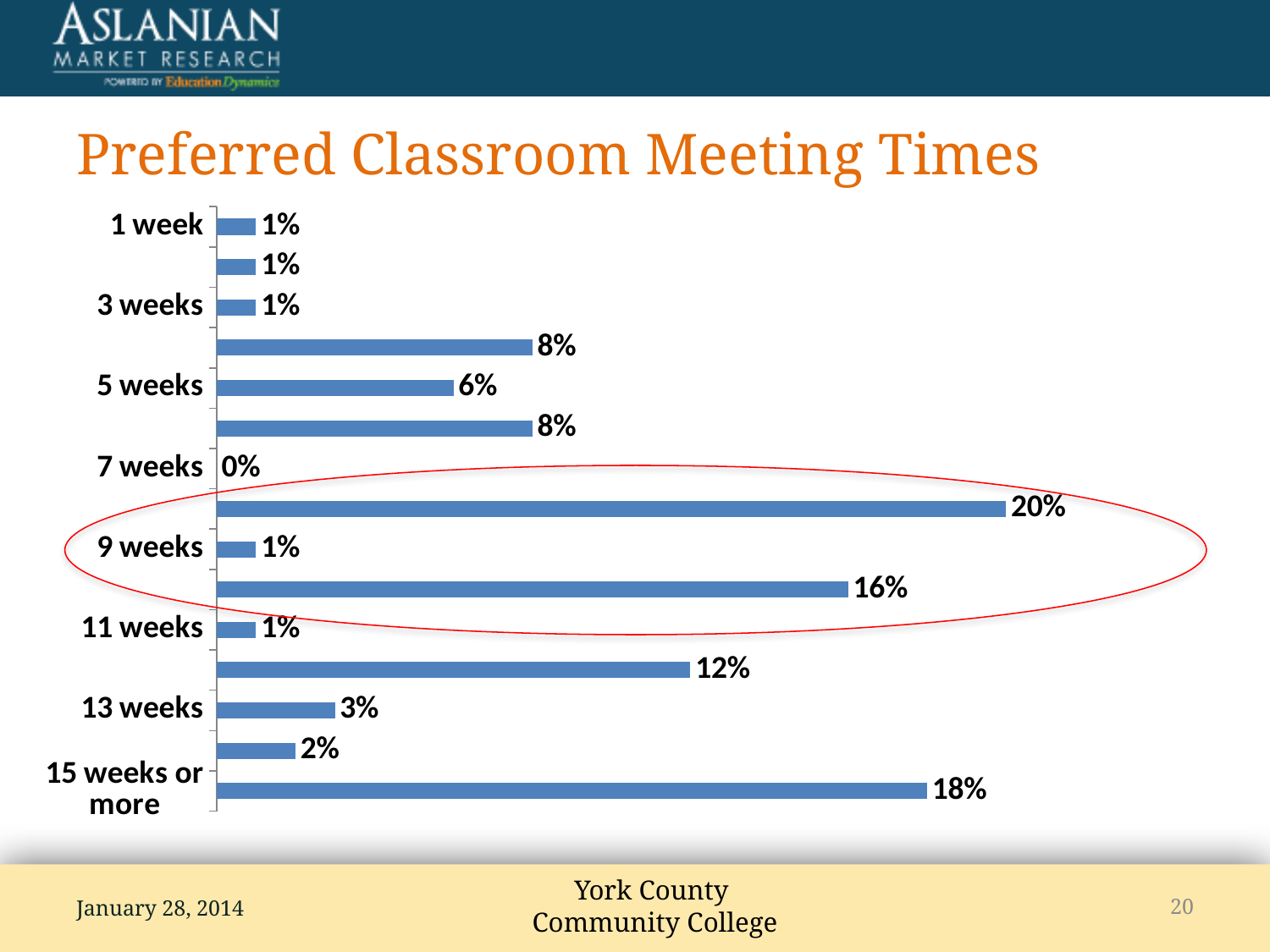
What is the difference between the values for 15 weeks or more and 5 weeks? 12% What is the value for 15 weeks or more? 18% What is the title of the chart? Preferred Classroom Meeting Times What is the value for 13 weeks? 3% How many bars are plotted on the chart? 15 What is the value for 7 weeks? 0% Which is larger, the value for 13 weeks or the value for 5 weeks? 5 weeks What is the value for 5 weeks? 6% What type of chart is shown on the slide? bar chart Which labeled category has the lowest value? 7 weeks What is the value for 9 weeks? 1% What is the highest value shown on the chart? 20%